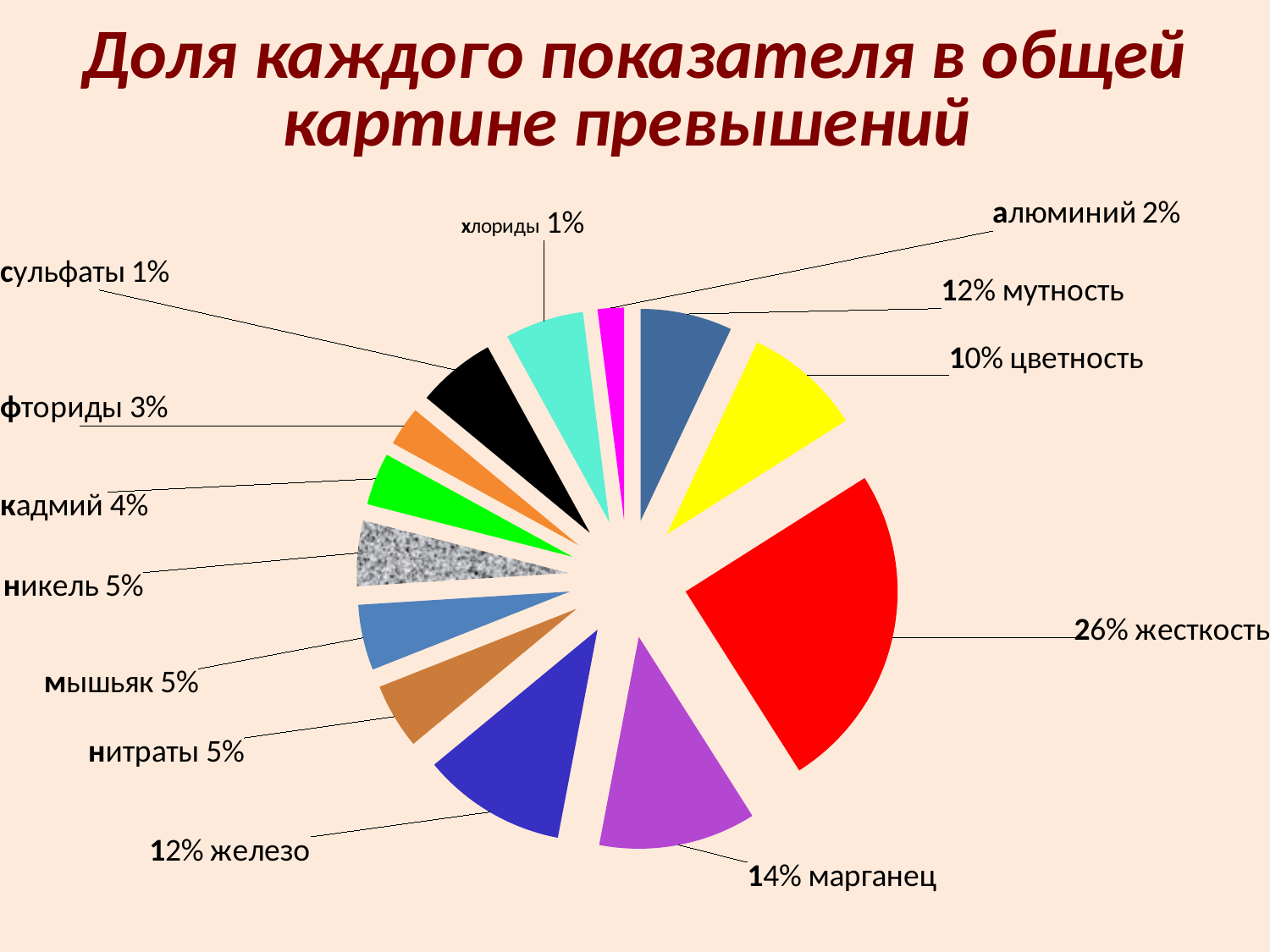
What is the title of the slide? Доля каждого показателя в общей картине превышений What kind of chart is shown on the slide? pie chart What is the share of марганец? 14% What is the share of цветность? 10% Which has a larger share, мутность or цветность? мутность What is the difference in percentage points between жесткость and марганец? 12 What is the share of кадмий? 4% How many slices does the pie chart have? 13 What is the share of жесткость? 26% What is the share of фториды? 3% Which has a larger share, алюминий or никель? никель Which indicator has the largest share in the pie chart? жесткость